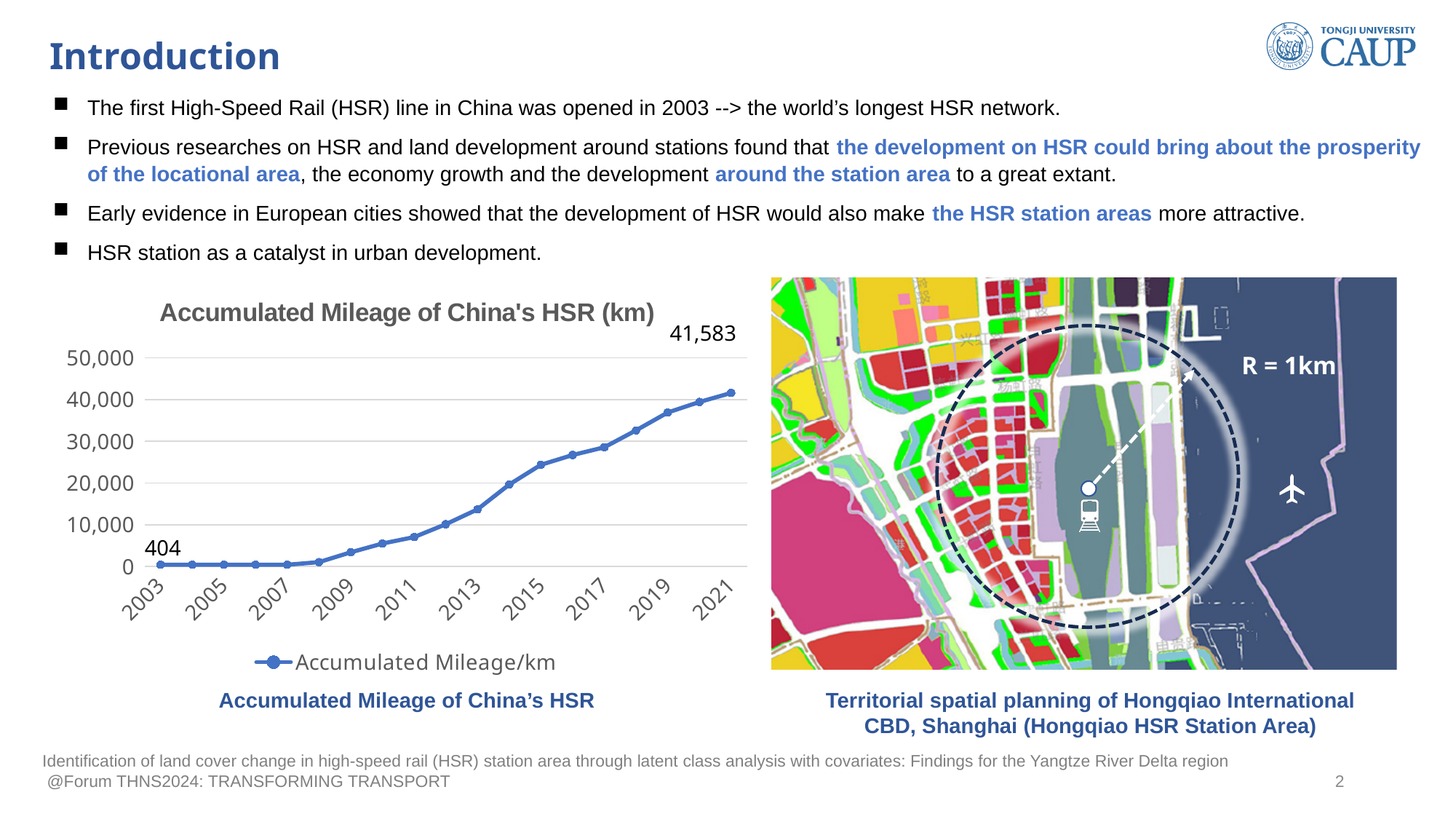
What is the accumulated mileage of China's HSR in 2003 according to the chart? 404 How many series does the legend of the accumulated mileage chart list? 1 Does the accumulated mileage rise or fall from 2003 to 2021? Rise Is the accumulated mileage in 2015 greater or less than 20,000? greater How many yearly data points are plotted on the accumulated mileage chart? 19 In which year is the accumulated mileage highest? 2021 What kind of chart is used to show the accumulated mileage of China's HSR? Line chart Is the accumulated mileage in 2009 greater or less than 10,000? less What is the accumulated mileage of China's HSR in 2021 according to the chart? 41,583 In which year is the accumulated mileage lowest? 2003 to 2007 (all tied at 404) By how much did the accumulated mileage increase from 2003 to 2021? 41,179 What is the legend entry of the accumulated mileage chart? Accumulated Mileage/km